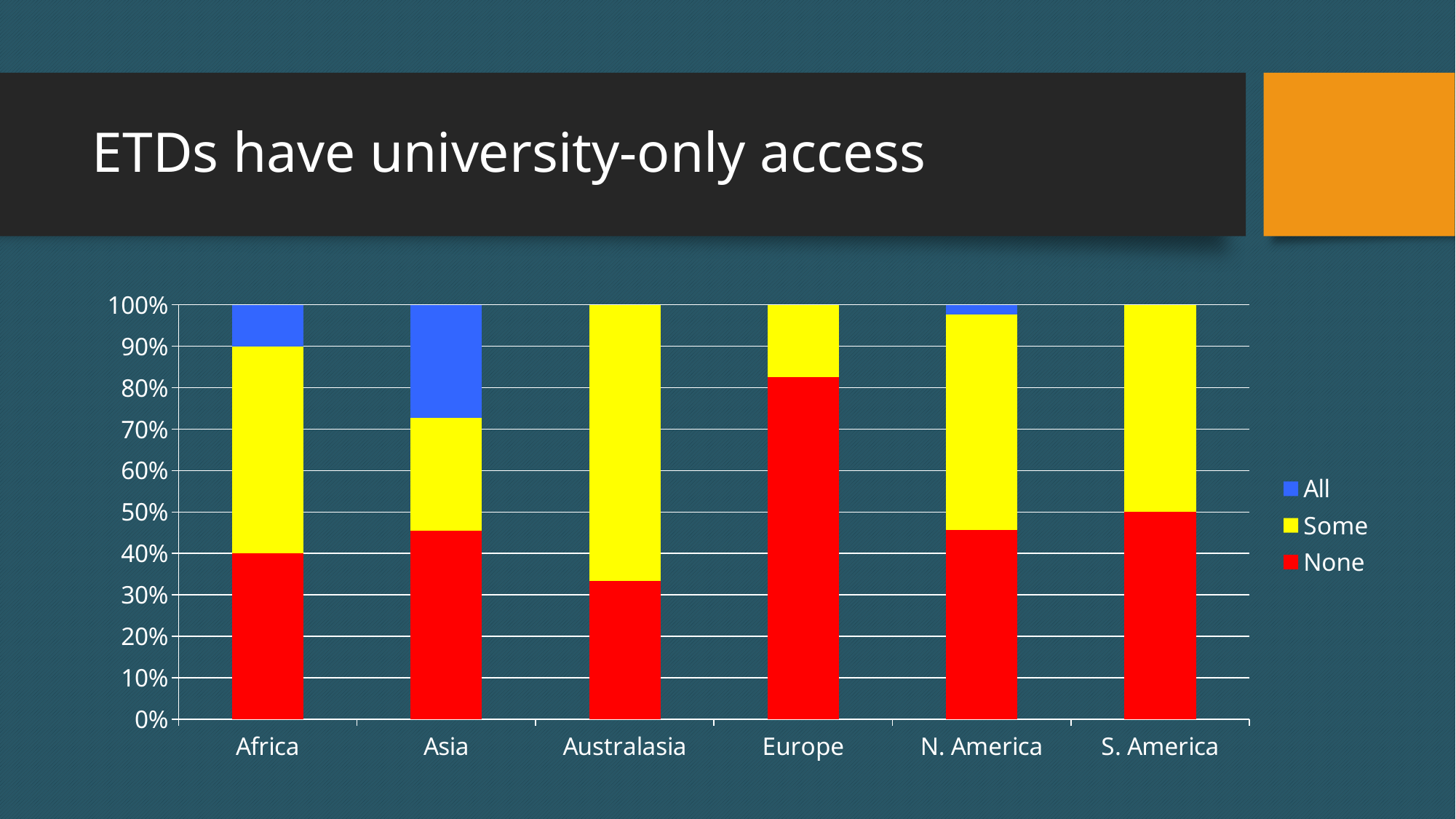
Is the 'All' share for Asia greater or less than 20%? greater Which colour represents the 'None' series in the legend? Red Is the 'None' share for Europe greater or less than 70%? greater What is the total of the stacked bar for Europe? 100% Which region has the smallest 'None' share? Australasia Which region has the largest 'None' share? Europe How many series does the chart's legend list? 3 Which region has the largest 'All' share? Asia Which is larger, the 'All' share for Asia or the 'All' share for Africa? Asia How many regions are shown on the x axis of the chart? 6 Is the 'None' share for Australasia greater or less than 40%? less What kind of chart is shown on the slide? Stacked bar chart